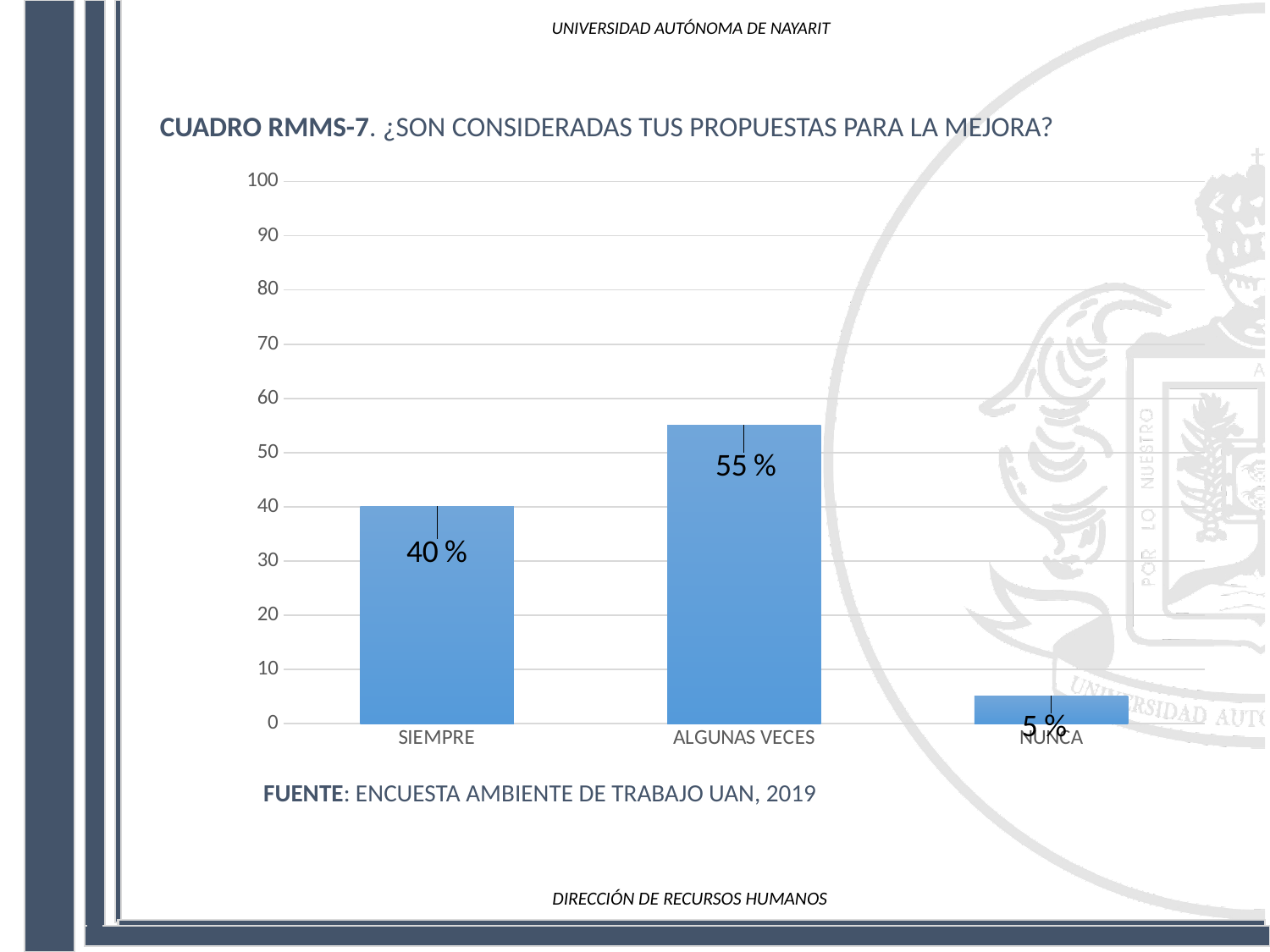
What is the value for NUNCA? 5 % What is the difference between the values for ALGUNAS VECES and SIEMPRE? 15 % Which category has the lowest value? NUNCA How many categories are shown on the x axis? 3 What is the title of the chart? CUADRO RMMS-7. ¿SON CONSIDERADAS TUS PROPUESTAS PARA LA MEJORA? What source is cited below the chart? ENCUESTA AMBIENTE DE TRABAJO UAN, 2019 Which is larger, the value for SIEMPRE or the value for NUNCA? SIEMPRE Which category has the highest value? ALGUNAS VECES What is the value for ALGUNAS VECES? 55 % What kind of chart is shown on the slide? bar chart Is the value for ALGUNAS VECES greater or less than 50? greater What is the value for SIEMPRE? 40 %